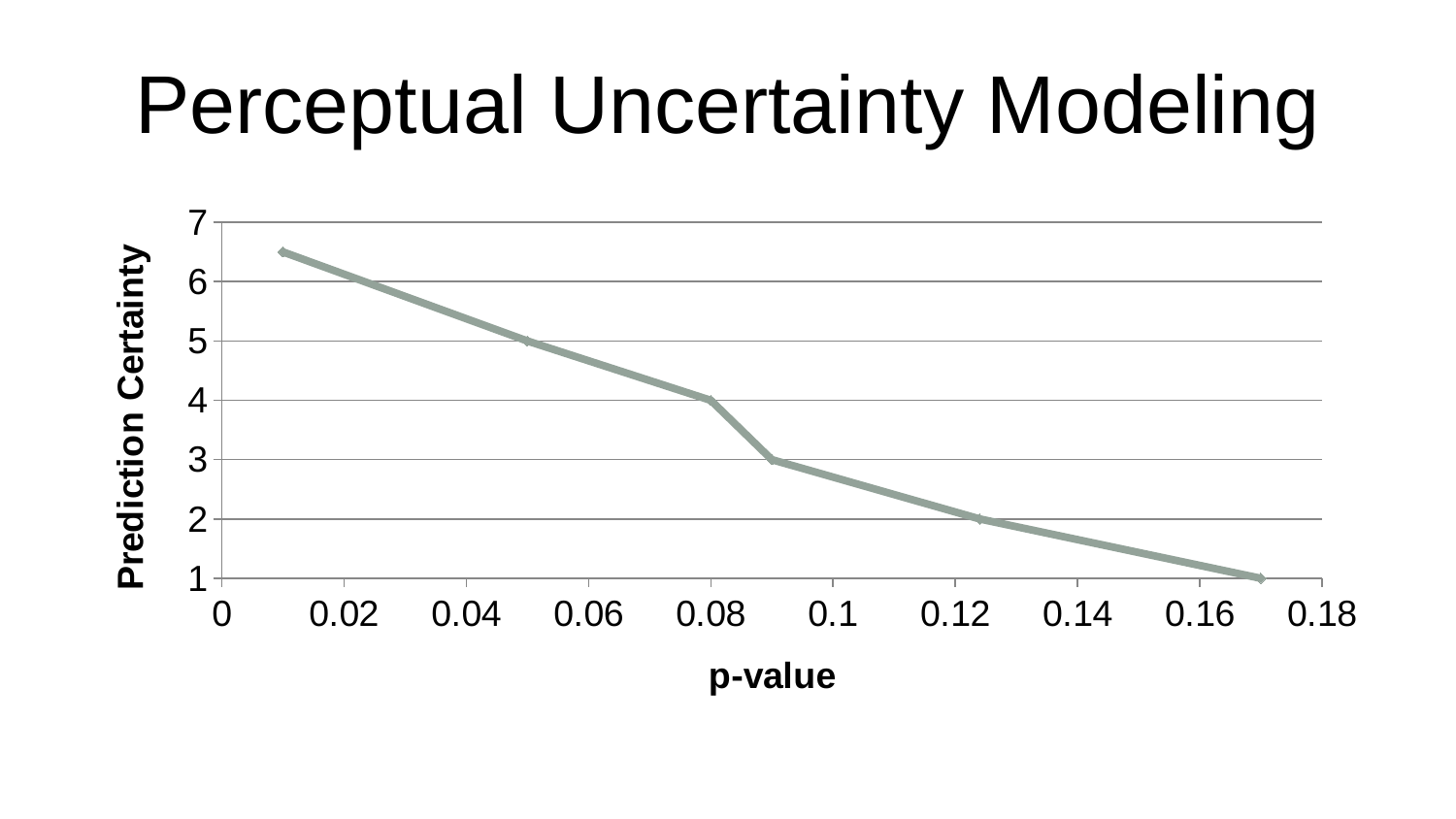
Does Prediction Certainty rise or fall as p-value increases along the x axis? fall How many data points are plotted on the line? 6 What is the Prediction Certainty at a p-value of 0.08? 4 Is the Prediction Certainty at the leftmost point greater or less than 5? greater What is the title of the y axis? Prediction Certainty Is the lowest Prediction Certainty value on the chart greater or less than 2? less Is the Prediction Certainty at a p-value of 0.08 greater or less than 5? less Which has the higher Prediction Certainty, the leftmost point or the rightmost point? the leftmost point What is the maximum value shown on the y axis? 7 What is the title of the x axis? p-value What kind of chart is shown on the slide? line chart